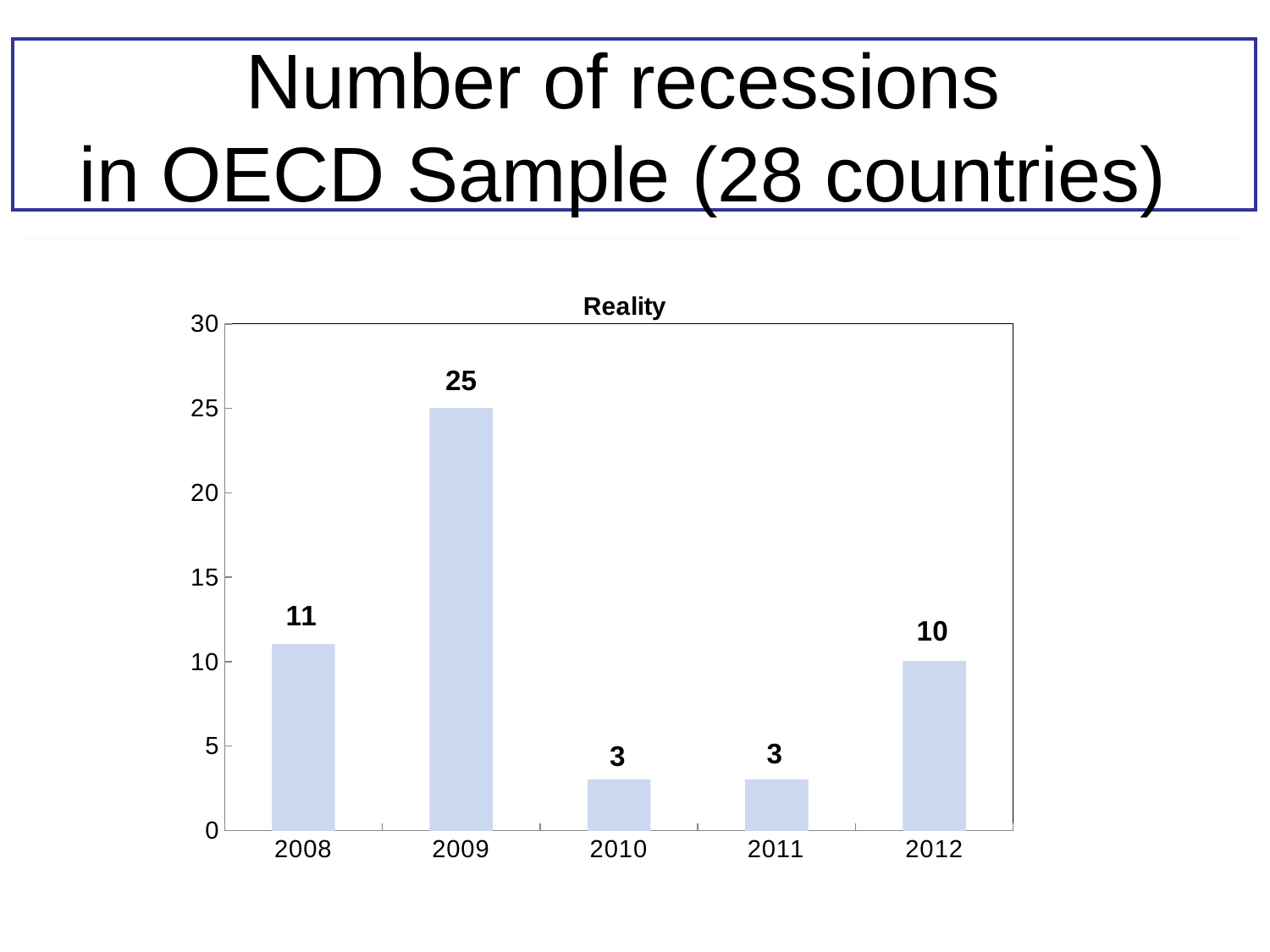
Which is larger, the value for 2008 or the value for 2012? 2008 What is the number of recessions in 2008? 11 Do the values rise or fall from 2009 to 2010? Fall Is the value for 2009 greater or less than 20? greater What kind of chart is shown on the slide? Bar chart What is the difference between the number of recessions in 2012 and 2011? 7 What is the difference between the number of recessions in 2009 and 2008? 14 How many years are shown on the x axis? 5 What is the number of recessions in 2012? 10 What is the number of recessions in 2009? 25 Which year has the highest number of recessions? 2009 What is the title printed above the chart's plot area? Reality